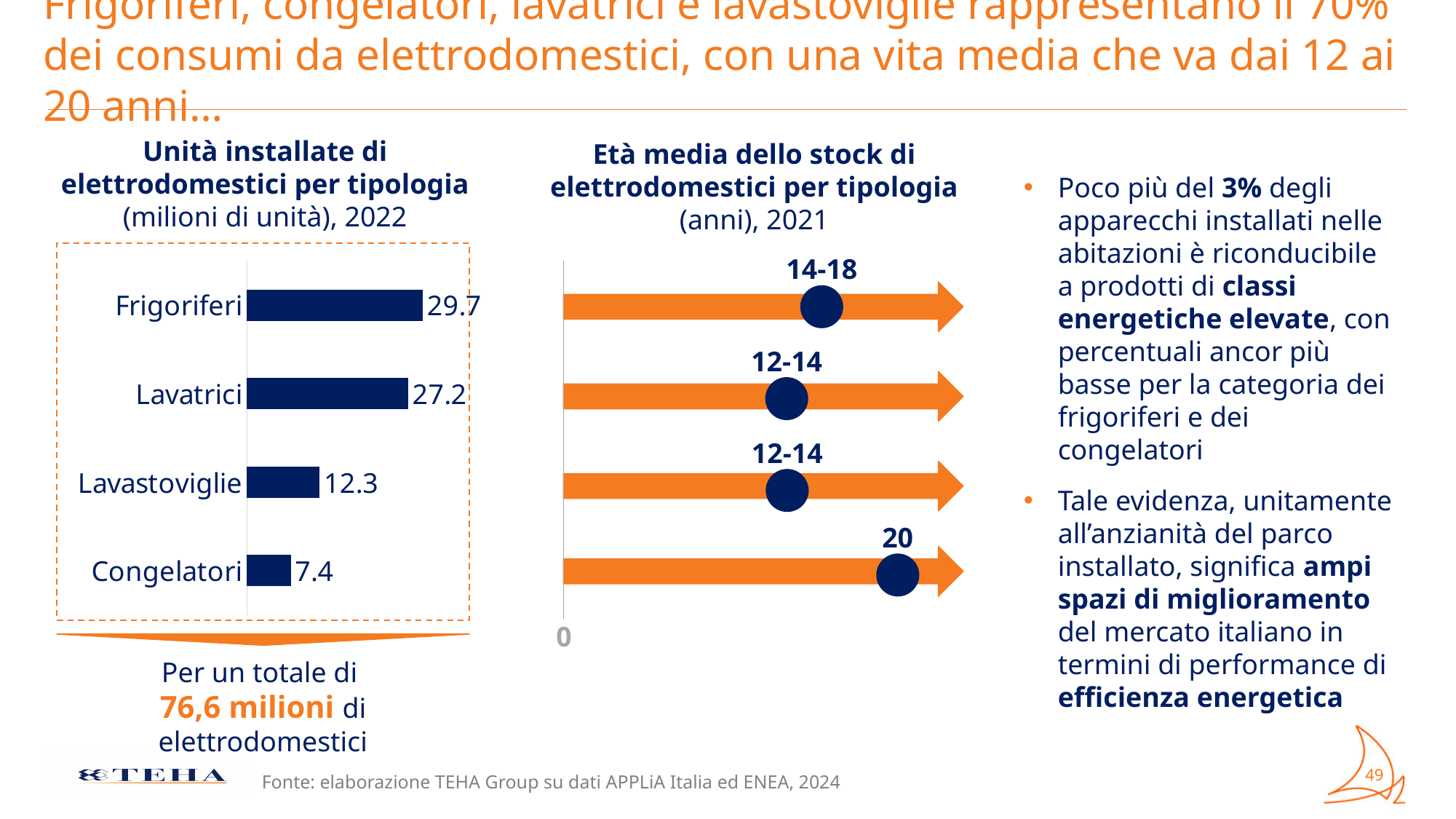
In the chart 'Età media dello stock di elettrodomestici per tipologia', what value is labelled on the bottom arrow? 20 In the chart 'Unità installate di elettrodomestici per tipologia', what unit is stated in the subtitle? milioni di unità In the chart 'Unità installate di elettrodomestici per tipologia', which category has the lowest value? Congelatori In the chart 'Unità installate di elettrodomestici per tipologia', which category has the highest value? Frigoriferi In the chart 'Unità installate di elettrodomestici per tipologia', what is the value for Frigoriferi? 29.7 In the chart 'Unità installate di elettrodomestici per tipologia', what is the difference between Frigoriferi and Lavatrici? 2.5 What kind of chart is 'Unità installate di elettrodomestici per tipologia'? Bar chart In the chart 'Unità installate di elettrodomestici per tipologia', which is larger, Lavastoviglie or Congelatori? Lavastoviglie In the chart 'Unità installate di elettrodomestici per tipologia', what is the value for Congelatori? 7.4 In the chart 'Unità installate di elettrodomestici per tipologia', what is the value for Lavastoviglie? 12.3 In the chart 'Età media dello stock di elettrodomestici per tipologia', what value is labelled on the top arrow? 14-18 How many categories are shown in the chart 'Unità installate di elettrodomestici per tipologia'? 4